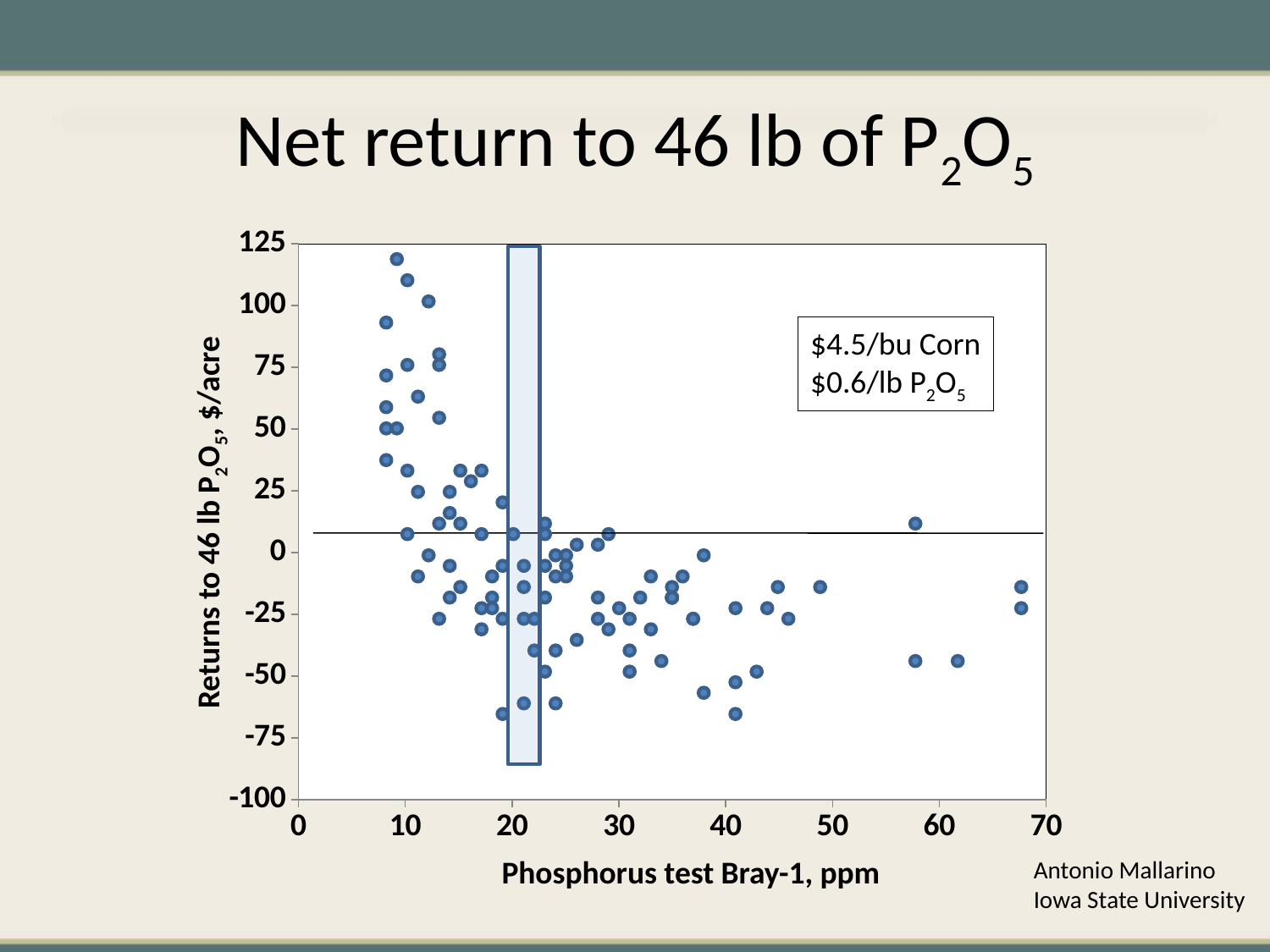
Is the lowest plotted return value greater or less than -50 $/acre? less What is the label of the x axis? Phosphorus test Bray-1, ppm What is the title of the chart? Net return to 46 lb of P2O5 Is the highest plotted return value greater or less than 100 $/acre? greater Which has the higher return: the point near 9 ppm at the top of the chart or the point near 41 ppm at the bottom of the chart? the point near 9 ppm What kind of chart is shown on the slide? scatter chart What is the minimum value shown on the y axis? -100 Are the return values for the points at about 68 ppm greater or less than 0 $/acre? less Do the return values generally rise or fall as the phosphorus test value increases along the x axis? fall